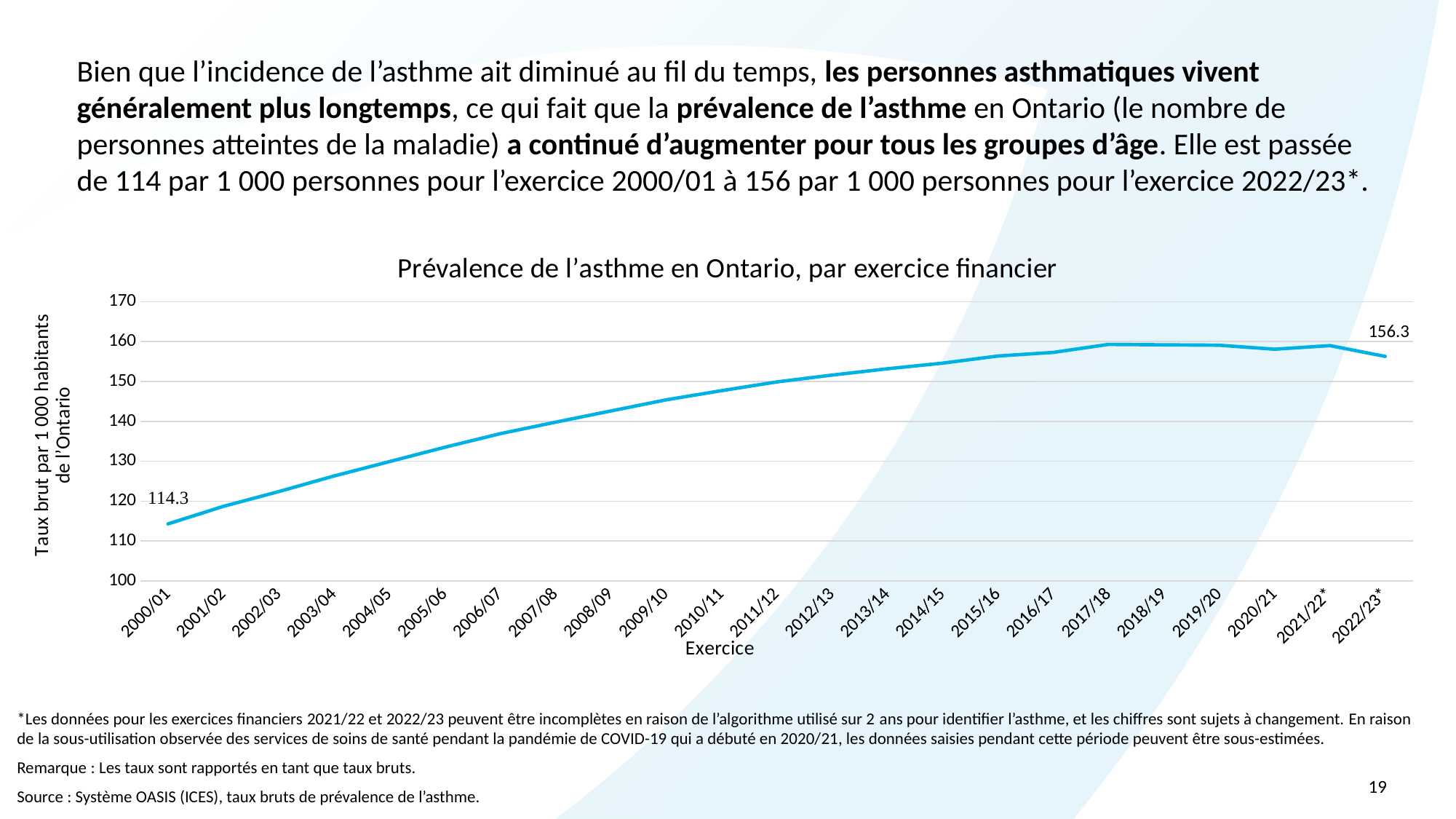
What is the asthma prevalence rate shown for fiscal year 2022/23? 156.3 Is the prevalence rate for 2003/04 greater or less than 130? less Is the prevalence rate for 2010/11 greater or less than 140? greater Does the prevalence rate generally rise or fall from 2000/01 to 2017/18? Rise By how much did the prevalence rate increase between 2000/01 and 2022/23, based on the printed data labels? 42 Which fiscal year has the lowest prevalence rate on the chart? 2000/01 What is the asthma prevalence rate shown for fiscal year 2000/01? 114.3 What type of chart is used to show asthma prevalence in Ontario? Line chart How many fiscal years are plotted on the x axis? 23 What is the title of the chart? Prévalence de l'asthme en Ontario, par exercice financier Which is larger, the prevalence rate for 2000/01 or for 2022/23? 2022/23 Is the prevalence rate for 2017/18 greater or less than 150? greater